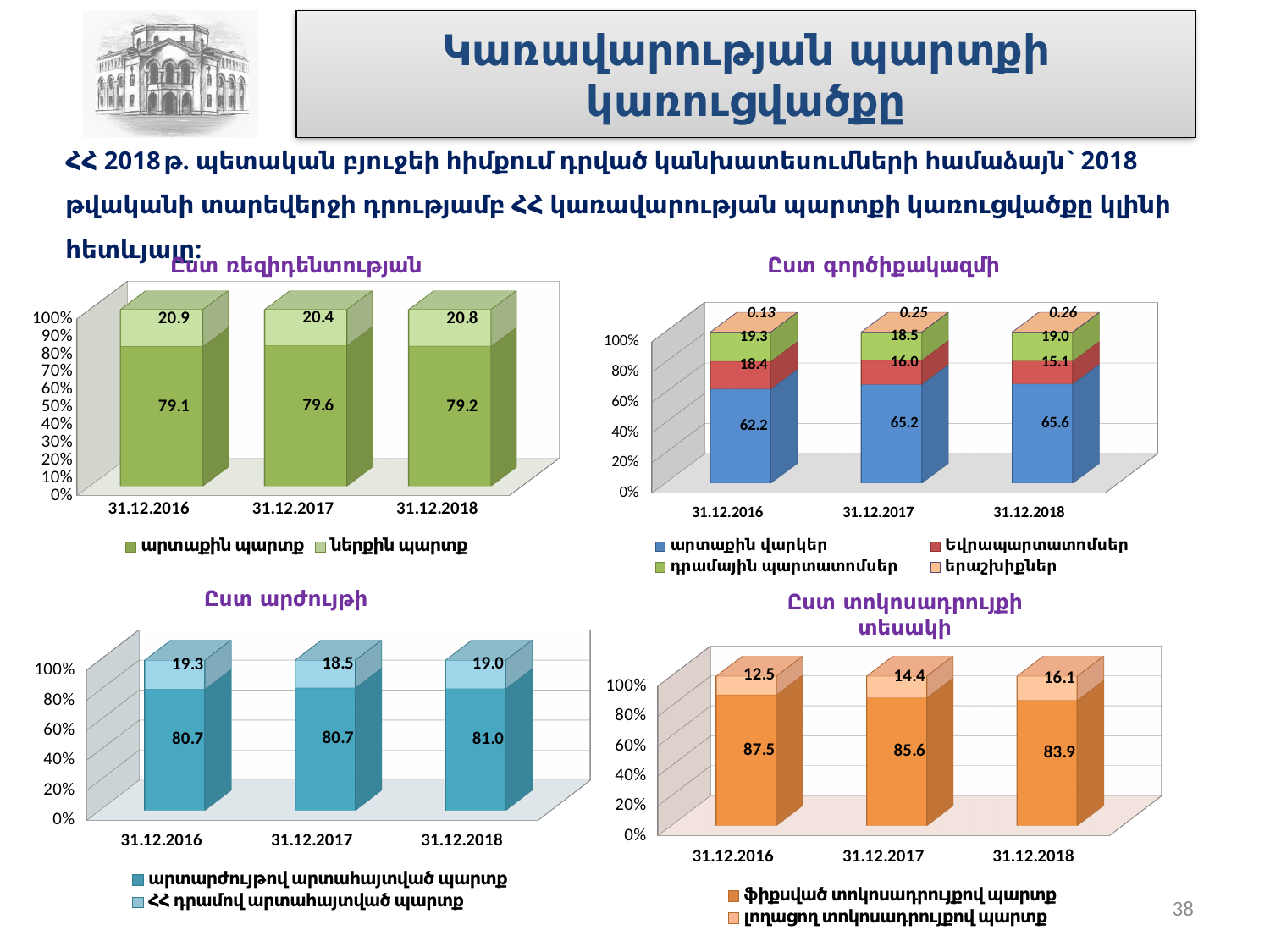
In the top-right chart (Ըստ գործիքակազմի), what is the value of երաշխիքներ for 31.12.2016? 0.13 In the bottom-right chart (Ըստ տոկոսադրույքի տեսակի), does the value of ֆիքսված տոկոսադրույքով պարտք rise or fall from 31.12.2016 to 31.12.2018? fall In the bottom-left chart (Ըստ արժույթի), what is the value of ՀՀ դրամով արտահայտված պարտք for 31.12.2017? 18.5 In the top-right chart (Ըստ գործիքակազմի), which date has the lowest value for Եվրապարտատոմսեր? 31.12.2018 In the top-right chart (Ըստ գործիքակազմի), what is the value of արտաքին վարկեր for 31.12.2018? 65.6 In the top-right chart (Ըստ գործիքակազմի), how many series does the legend list? 4 What kind of chart is the top-left chart (Ըստ ռեզիդենտության)? stacked bar chart In the bottom-left chart (Ըստ արժույթի), what is the difference between արտարժույթով արտահայտված պարտք and ՀՀ դրամով արտահայտված պարտք for 31.12.2018? 62.0 In the top-left chart (Ըստ ռեզիդենտության), what is the value of արտաքին պարտք for 31.12.2017? 79.6 In the top-left chart (Ըստ ռեզիդենտության), what is the value of ներքին պարտք for 31.12.2016? 20.9 In the bottom-right chart (Ըստ տոկոսադրույքի տեսակի), what is the value of լողացող տոկոսադրույքով պարտք for 31.12.2018? 16.1 How many dates are shown on the x axis of the bottom-right chart (Ըստ տոկոսադրույքի տեսակի)? 3